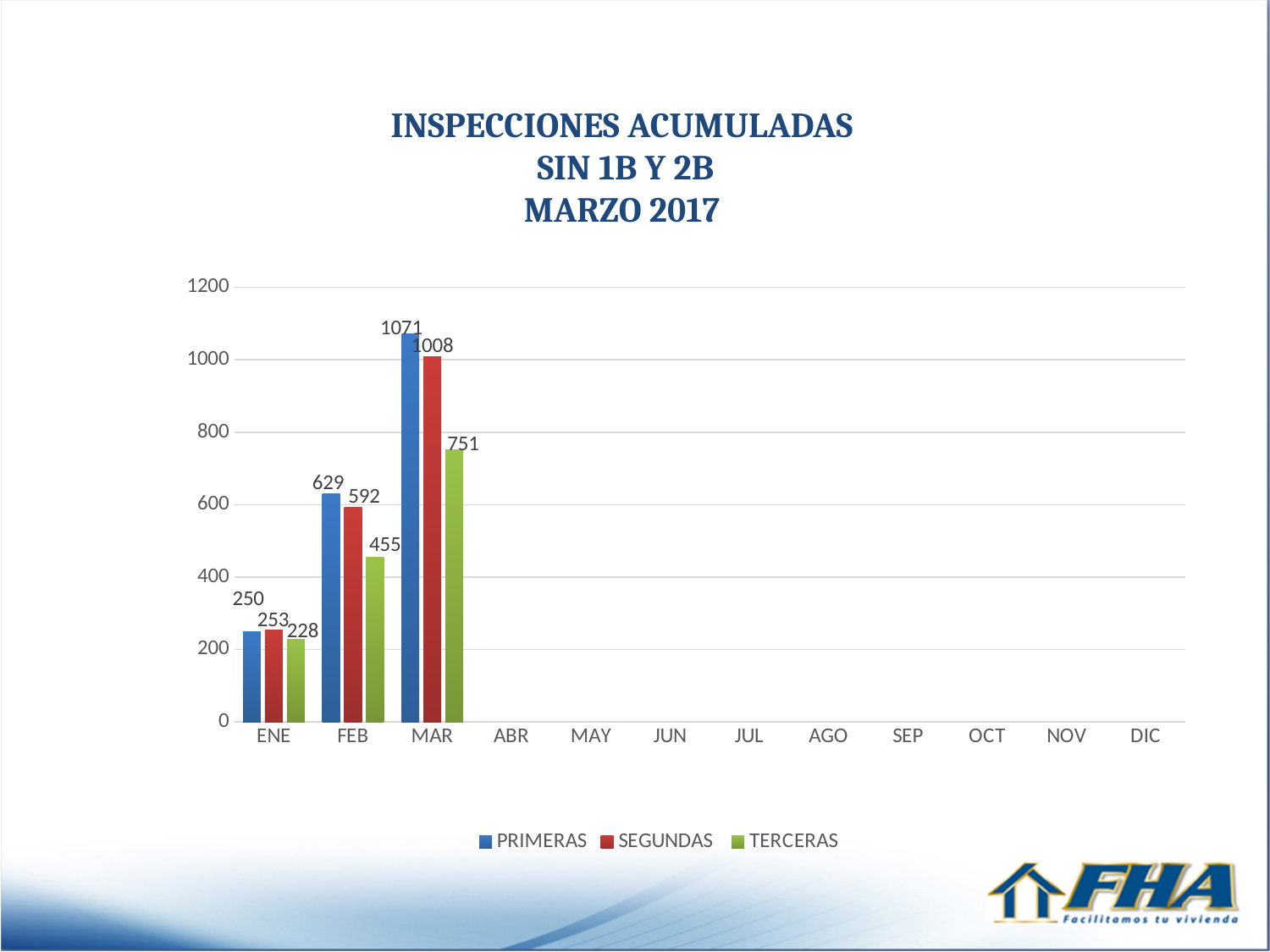
What is the value for SEGUNDAS in ENE? 253 Which month has the lowest value for TERCERAS among the months with data? ENE How many series does the legend list? 3 Which is larger in FEB, PRIMERAS or TERCERAS? PRIMERAS What is the value for PRIMERAS in MAR? 1071 What kind of chart is shown on the slide? bar chart How many month categories are shown on the x axis? 12 What is the value for TERCERAS in FEB? 455 Which month has the highest value for PRIMERAS? MAR Do the values for TERCERAS rise or fall from ENE to MAR? rise What is the difference between PRIMERAS and SEGUNDAS in MAR? 63 Is the value for SEGUNDAS in MAR greater or less than 1000? greater